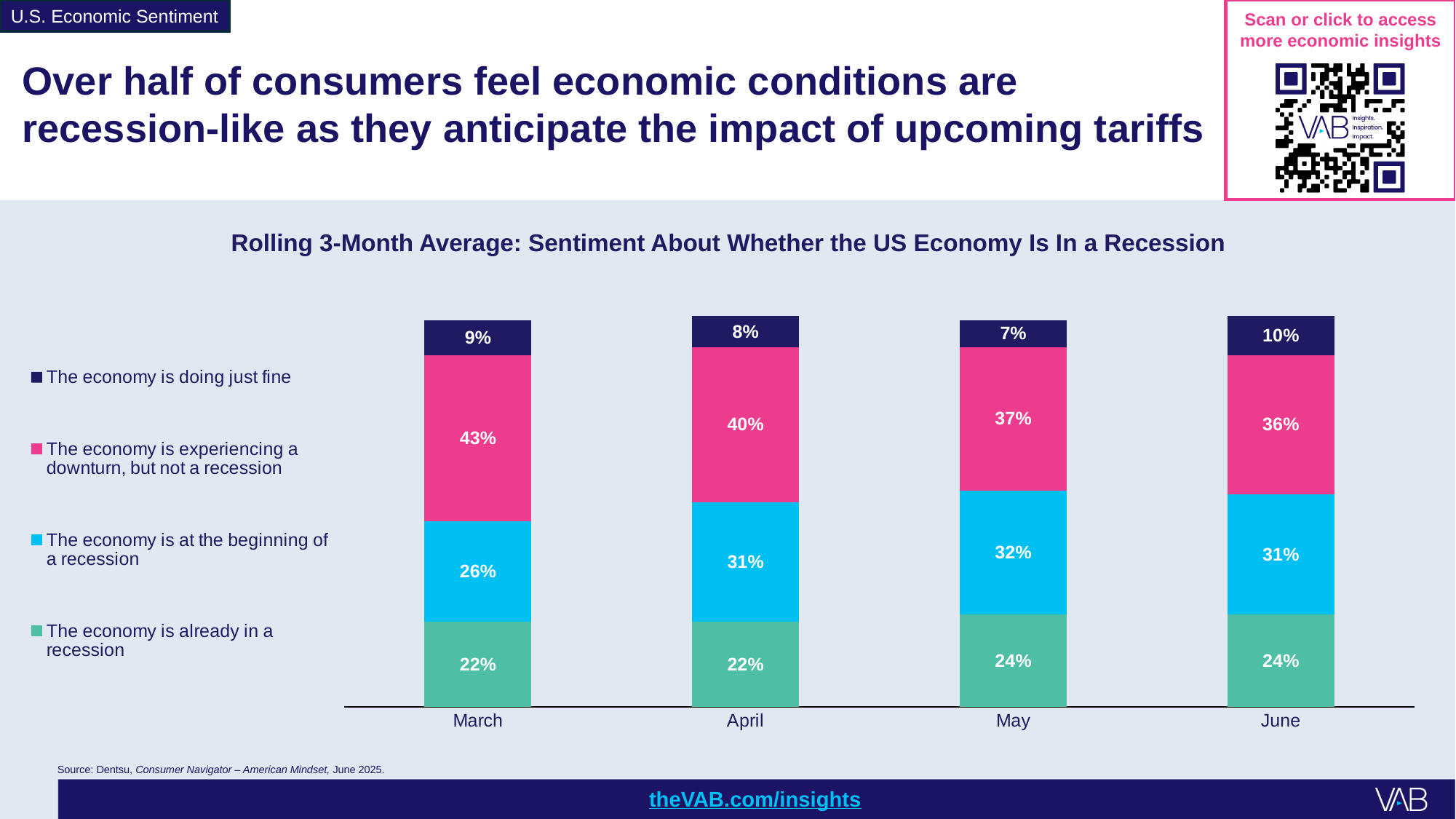
Does the share saying the economy is experiencing a downturn, but not a recession rise or fall from March to June? Fall What percentage of consumers said the economy is at the beginning of a recession in April? 31% What percentage of consumers said the economy is experiencing a downturn, but not a recession in March? 43% What percentage of consumers said the economy is doing just fine in May? 7% In which month was the share saying the economy is doing just fine the lowest? May How many series does the legend list? 4 What percentage of consumers said the economy is already in a recession in June? 24% Which is larger: the share saying the economy is experiencing a downturn, but not a recession in April, or the same share in June? April What is the difference between the share saying the economy is at the beginning of a recession in May and in March? 6 percentage points In which month was the share saying the economy is experiencing a downturn, but not a recession the highest? March What kind of chart is shown on the slide? Stacked bar chart How many months are shown on the x axis? 4